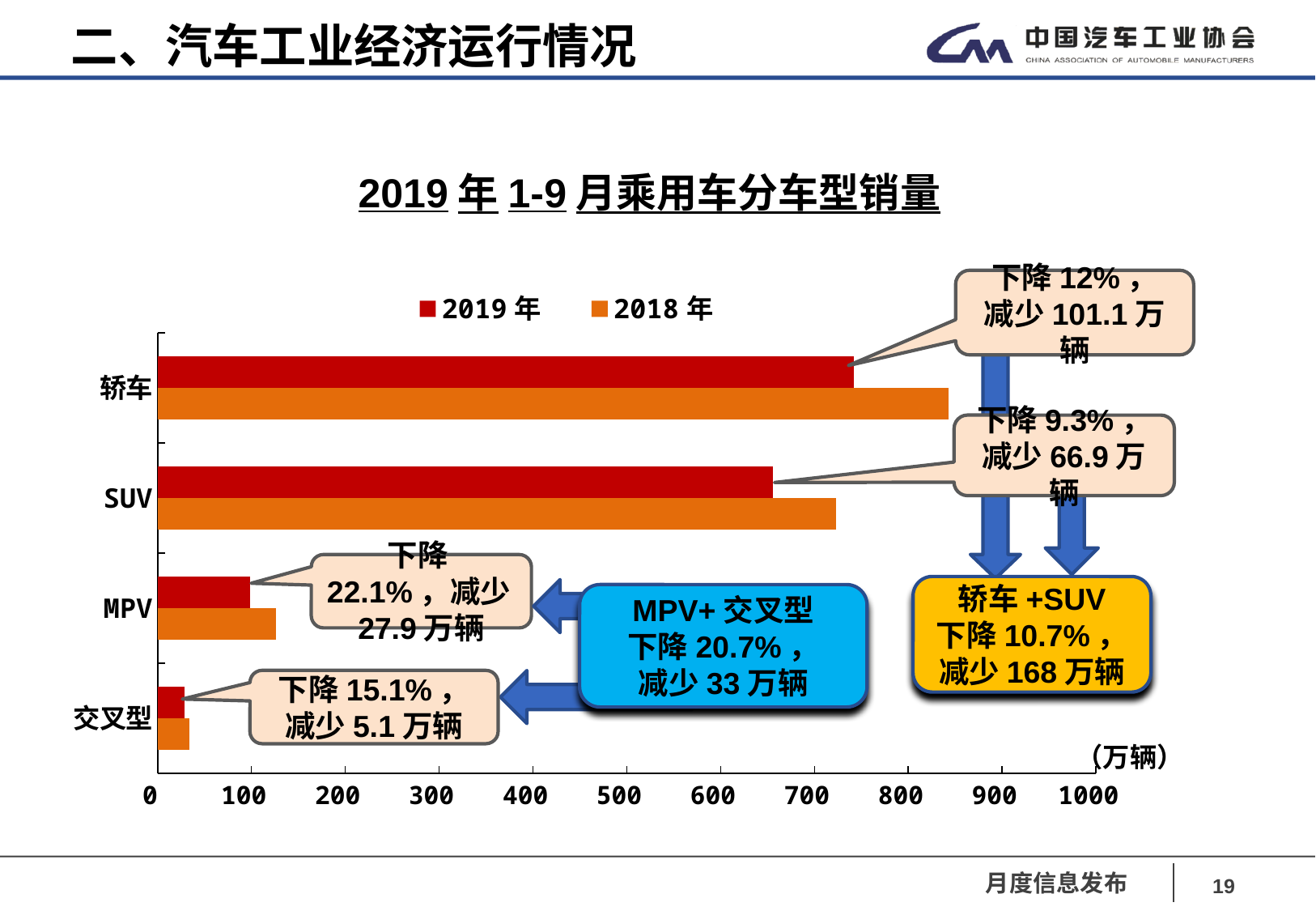
Is the 2019年 value for SUV greater or less than 700? less Is the 2018年 value for 轿车 greater or less than 800? greater Is the 2019年 value for 轿车 greater or less than 700? greater According to the callout, by how many 万辆 did MPV sales decrease? 27.9 万辆 What kind of chart is shown on the slide? bar chart Which is larger, the 2019年 value for 轿车 or the 2019年 value for SUV? 轿车 How many vehicle categories are shown on the y axis? 4 Which category has the lowest 2018年 sales? 交叉型 How many series does the legend list? 2 Which category has the highest 2019年 sales? 轿车 According to the callout, by what percentage did 轿车 sales decline? 12%